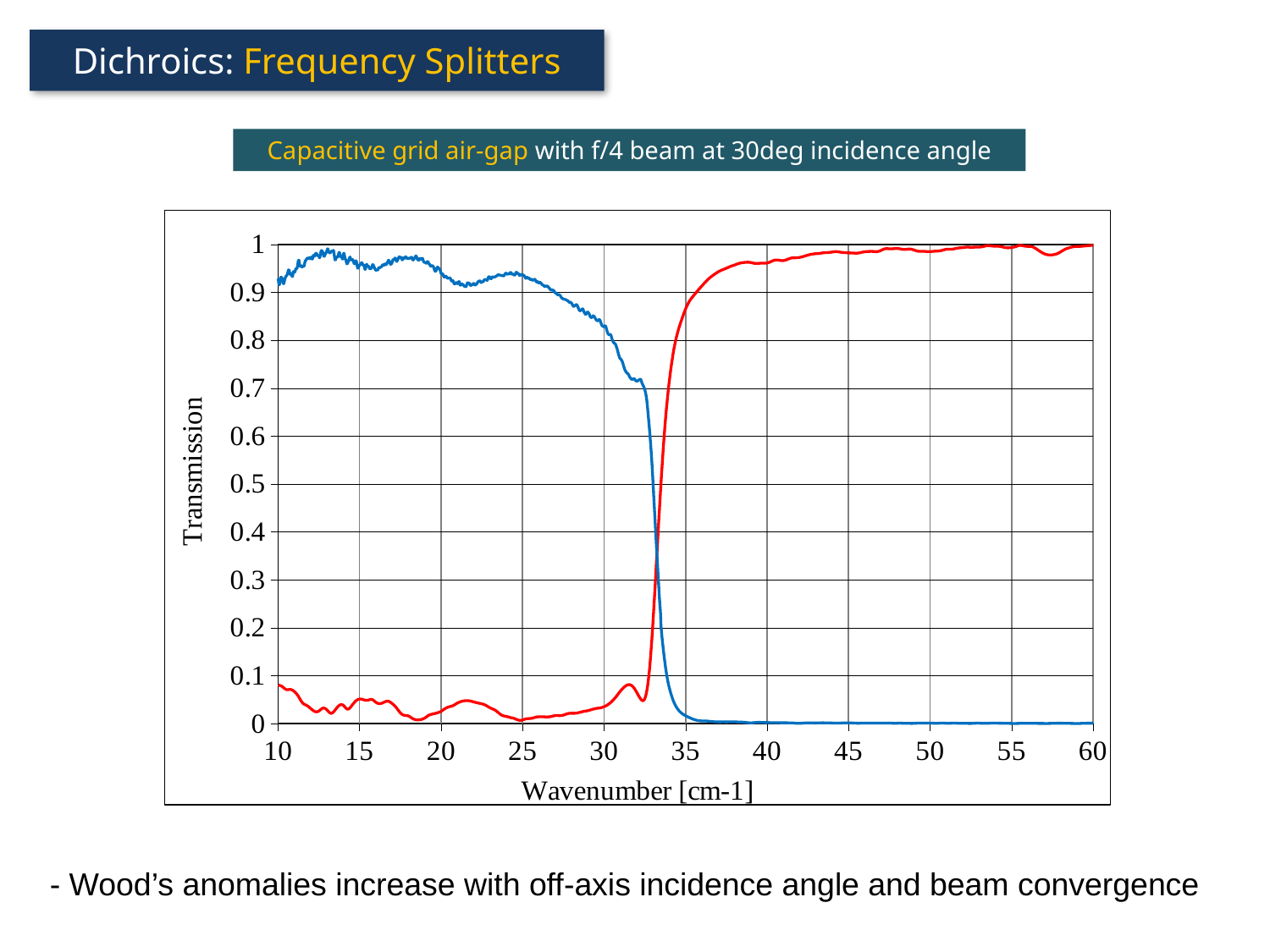
Is the value of the red line at wavenumber 50 greater or less than 0.9? greater Does the red line generally rise or fall as wavenumber increases from 10 to 60? rise Does the blue line generally rise or fall as wavenumber increases from 10 to 60? fall What kind of chart is shown on the slide? line chart Is the value of the red line at wavenumber 20 greater or less than 0.1? less What is the label of the y axis? Transmission Is the value of the blue line at wavenumber 30 greater or less than 0.7? greater What is the label of the x axis? Wavenumber [cm-1] At wavenumber 45, which line has the higher transmission, the red line or the blue line? the red line How many lines (series) are plotted on the chart? 2